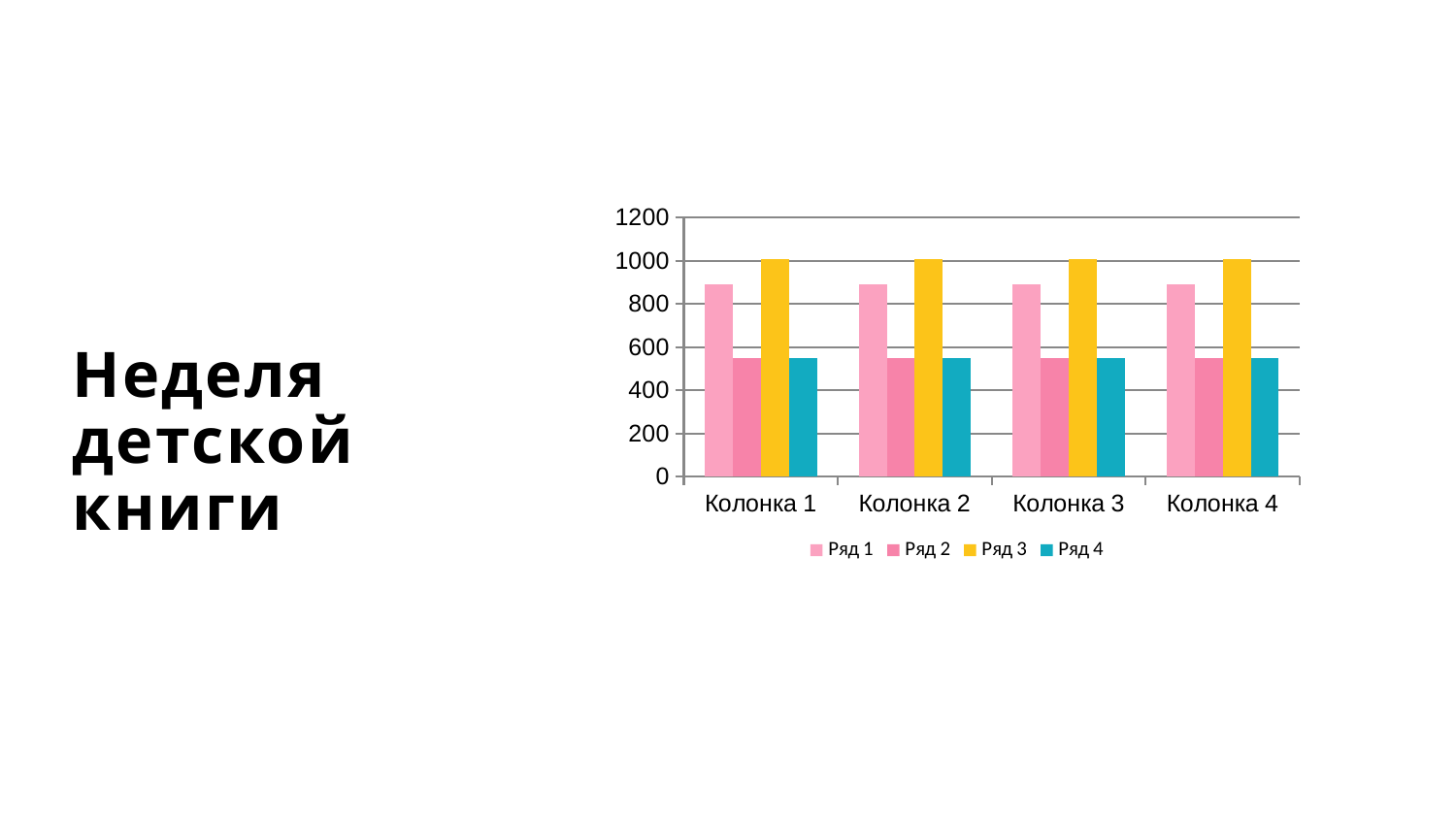
Is the value for Ряд 4 in Колонка 4 greater or less than 400? greater Do the values for Ряд 1 rise, fall, or stay the same across Колонка 1 to Колонка 4? stay the same What colour are the bars for Ряд 3 in the chart? yellow How many series does the chart legend list? 4 What kind of chart is shown on the slide? bar chart Which series has the highest bar in Колонка 1? Ряд 3 Is the value for Ряд 3 in Колонка 2 greater or less than 800? greater How many categories are shown on the x axis of the chart? 4 Is the value for Ряд 1 in Колонка 2 greater or less than 800? greater In Колонка 4, which is larger: the value for Ряд 3 or the value for Ряд 4? Ряд 3 In Колонка 1, which is larger: the value for Ряд 1 or the value for Ряд 2? Ряд 1